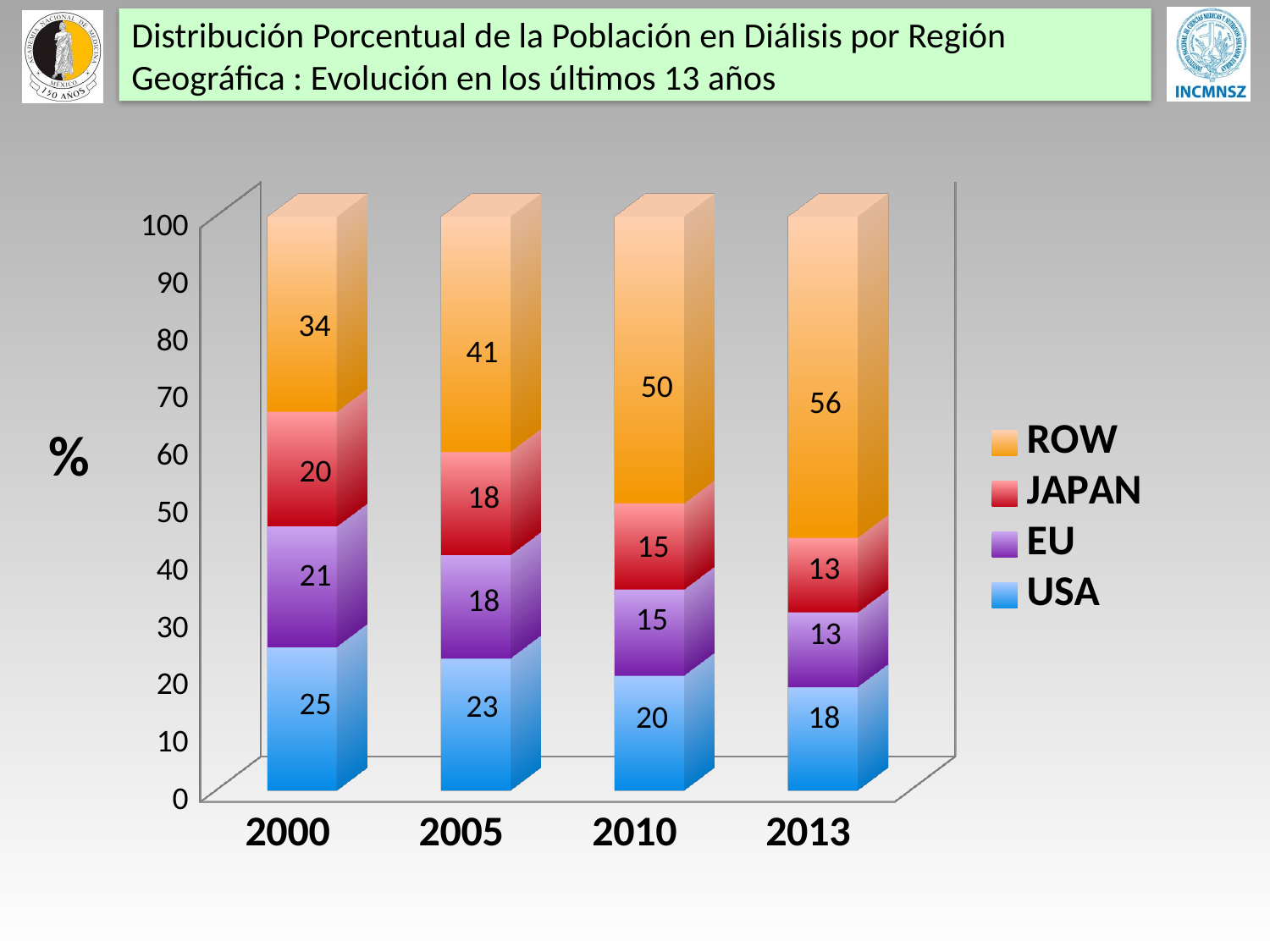
What is the difference between the ROW value in 2013 and the ROW value in 2000? 22 How many series does the legend list? 4 What is the value for EU in 2010? 15 What is the value for ROW in 2013? 56 In which year is the USA value lowest? 2013 In which year is the ROW value highest? 2013 Which is larger, the JAPAN value in 2000 or the JAPAN value in 2010? 2000 Does the USA value rise or fall from 2000 to 2013? Fall What is the value for USA in 2000? 25 What kind of chart is shown on the slide? Stacked bar chart What is the value for JAPAN in 2005? 18 How many years are shown on the x axis? 4